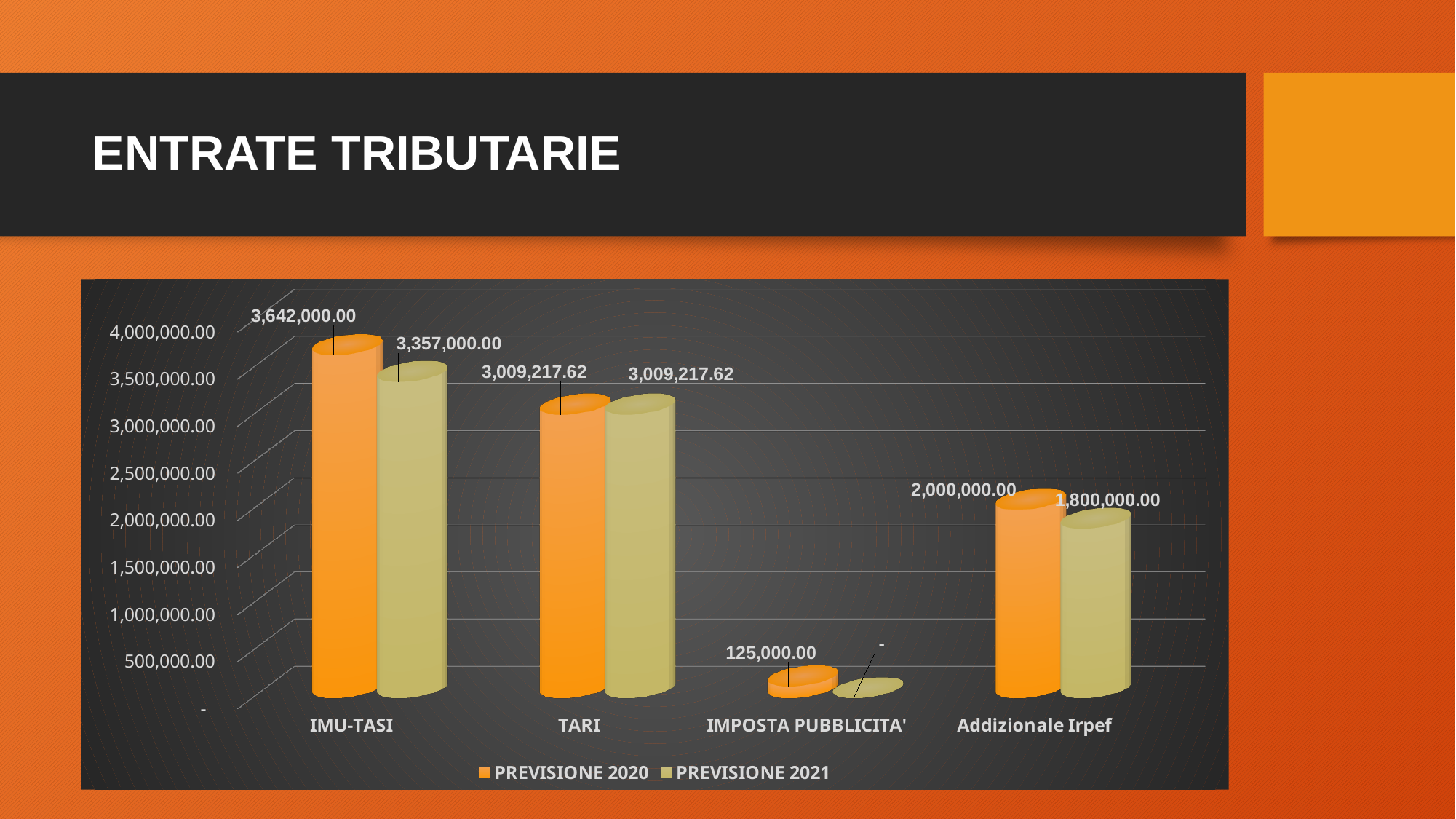
What is the PREVISIONE 2020 value for IMPOSTA PUBBLICITA'? 125,000.00 What is the PREVISIONE 2021 value for Addizionale Irpef? 1,800,000.00 What is the PREVISIONE 2020 value for IMU-TASI? 3,642,000.00 What is the difference between the PREVISIONE 2020 and PREVISIONE 2021 values for IMU-TASI? 285,000.00 How many categories are shown on the x axis of the chart? 4 Which is larger for Addizionale Irpef: the PREVISIONE 2020 value or the PREVISIONE 2021 value? PREVISIONE 2020 What is the PREVISIONE 2021 value for IMU-TASI? 3,357,000.00 Which category has the highest PREVISIONE 2020 value? IMU-TASI What is the difference between the PREVISIONE 2020 and PREVISIONE 2021 values for Addizionale Irpef? 200,000.00 Which category has the lowest PREVISIONE 2020 value? IMPOSTA PUBBLICITA' What is the PREVISIONE 2020 value for TARI? 3,009,217.62 How many series does the chart legend list? 2